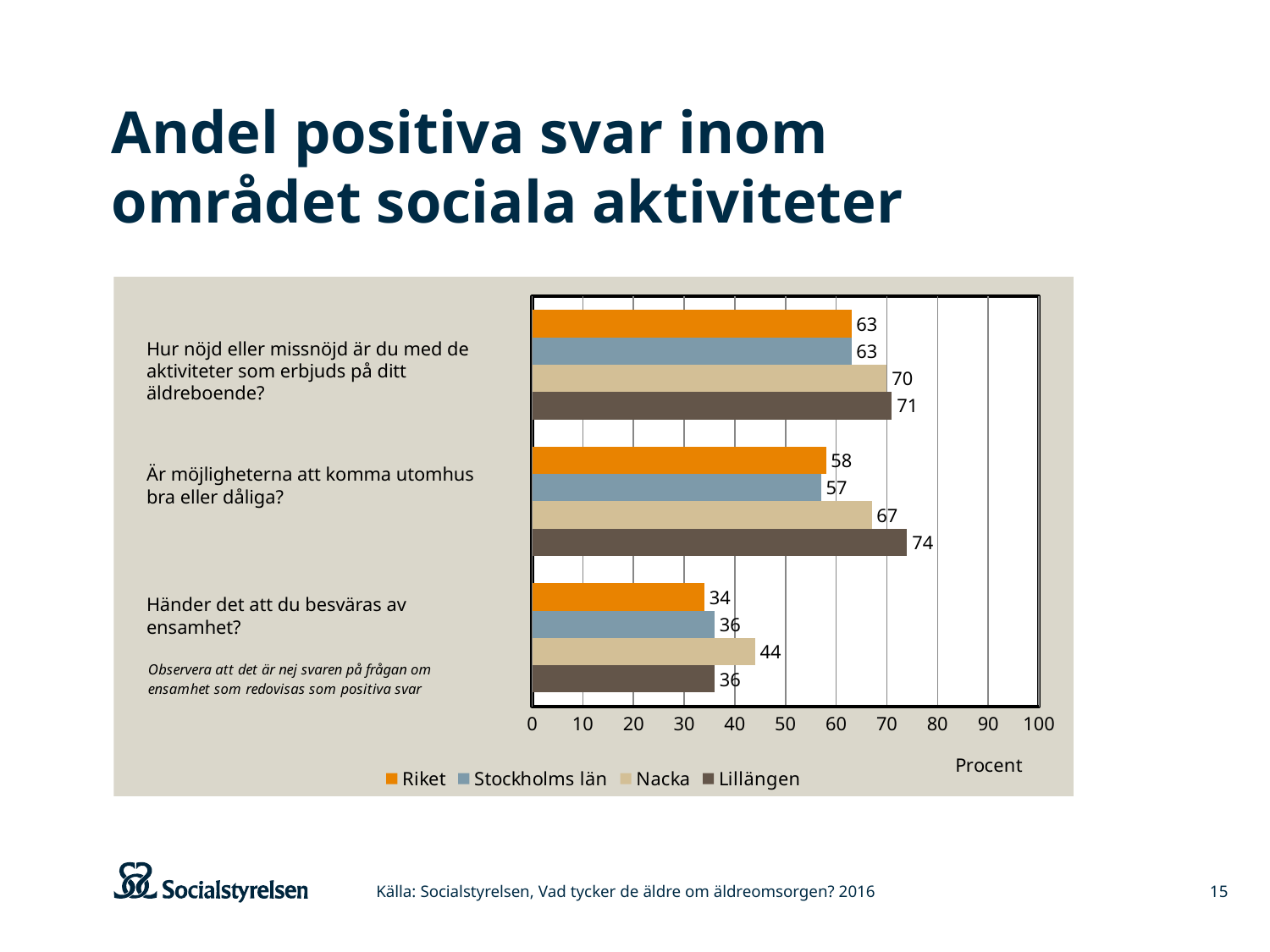
How many series does the legend list? 4 What is the difference between Lillängen and Riket on the question "Är möjligheterna att komma utomhus bra eller dåliga?"? 16 Which series has the lowest value on the question "Händer det att du besväras av ensamhet?"? Riket What is the value for Riket on the question "Hur nöjd eller missnöjd är du med de aktiviteter som erbjuds på ditt äldreboende?"? 63 Which series has the highest value on the question "Är möjligheterna att komma utomhus bra eller dåliga?"? Lillängen What is the value for Nacka on the question "Händer det att du besväras av ensamhet?"? 44 What is the value for Lillängen on the question "Är möjligheterna att komma utomhus bra eller dåliga?"? 74 Is the value for Nacka on the question "Är möjligheterna att komma utomhus bra eller dåliga?" greater or less than 60? greater How many questions (categories) are shown on the chart? 3 What kind of chart is shown on the slide? bar chart Which is larger on the question "Hur nöjd eller missnöjd är du med de aktiviteter som erbjuds på ditt äldreboende?": Nacka or Stockholms län? Nacka What unit is labelled on the horizontal axis of the chart? Procent